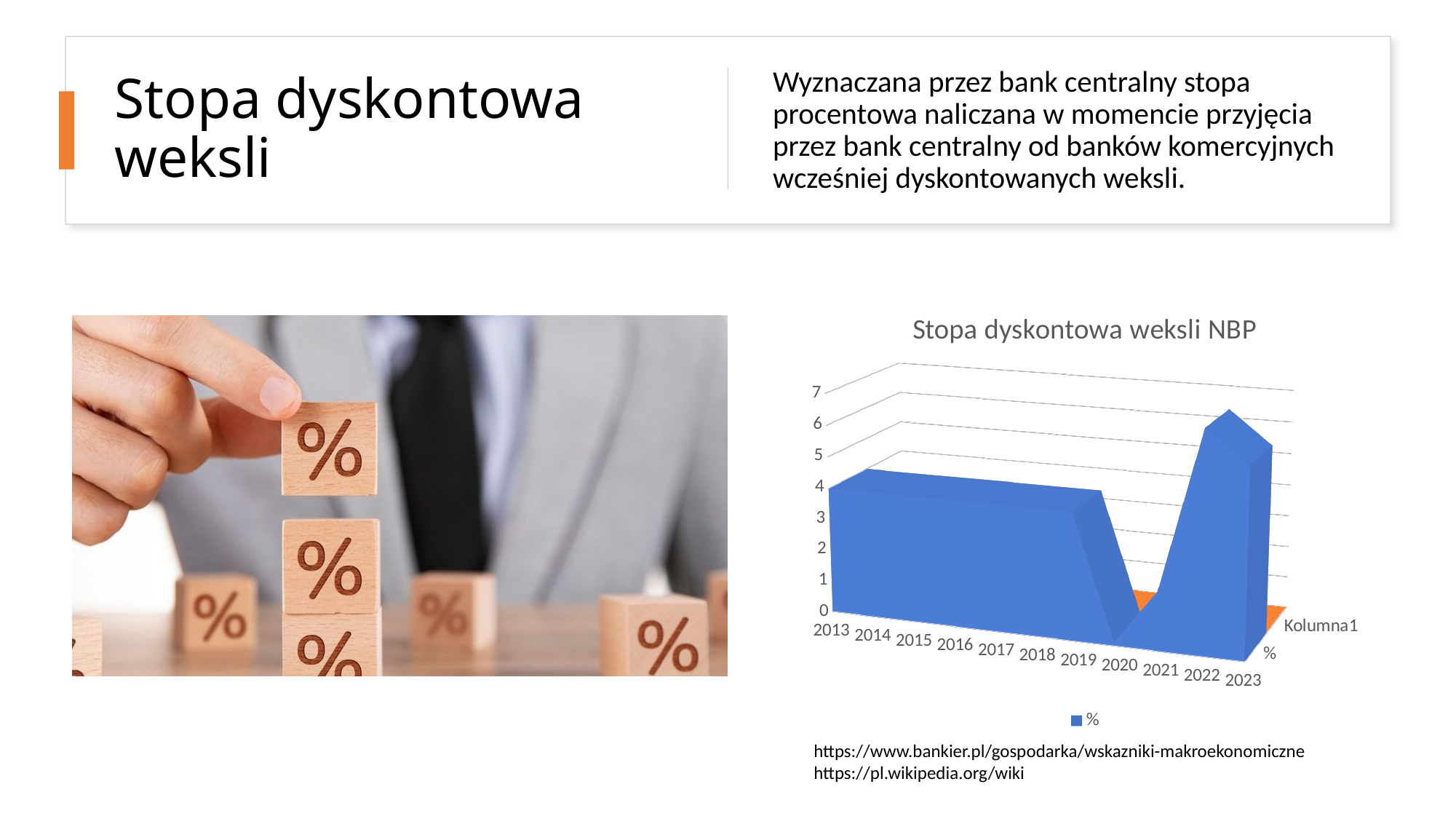
How many years are shown on the x axis of the chart? 11 What is the name of the series shown in the chart legend? % How many series does the chart legend list? 1 What kind of chart is shown on the slide? area chart Does the value rise or fall from 2021 to 2022? rise Is the value for 2013 greater or less than 2? greater Which is larger, the value for 2022 or the value for 2020? 2022 Is the value for 2022 greater or less than 4? greater Which year has the highest value in the chart? 2022 What is the title of the chart on the slide? Stopa dyskontowa weksli NBP Does the value rise or fall from 2019 to 2020? fall Is the value for 2020 greater or less than 2? less